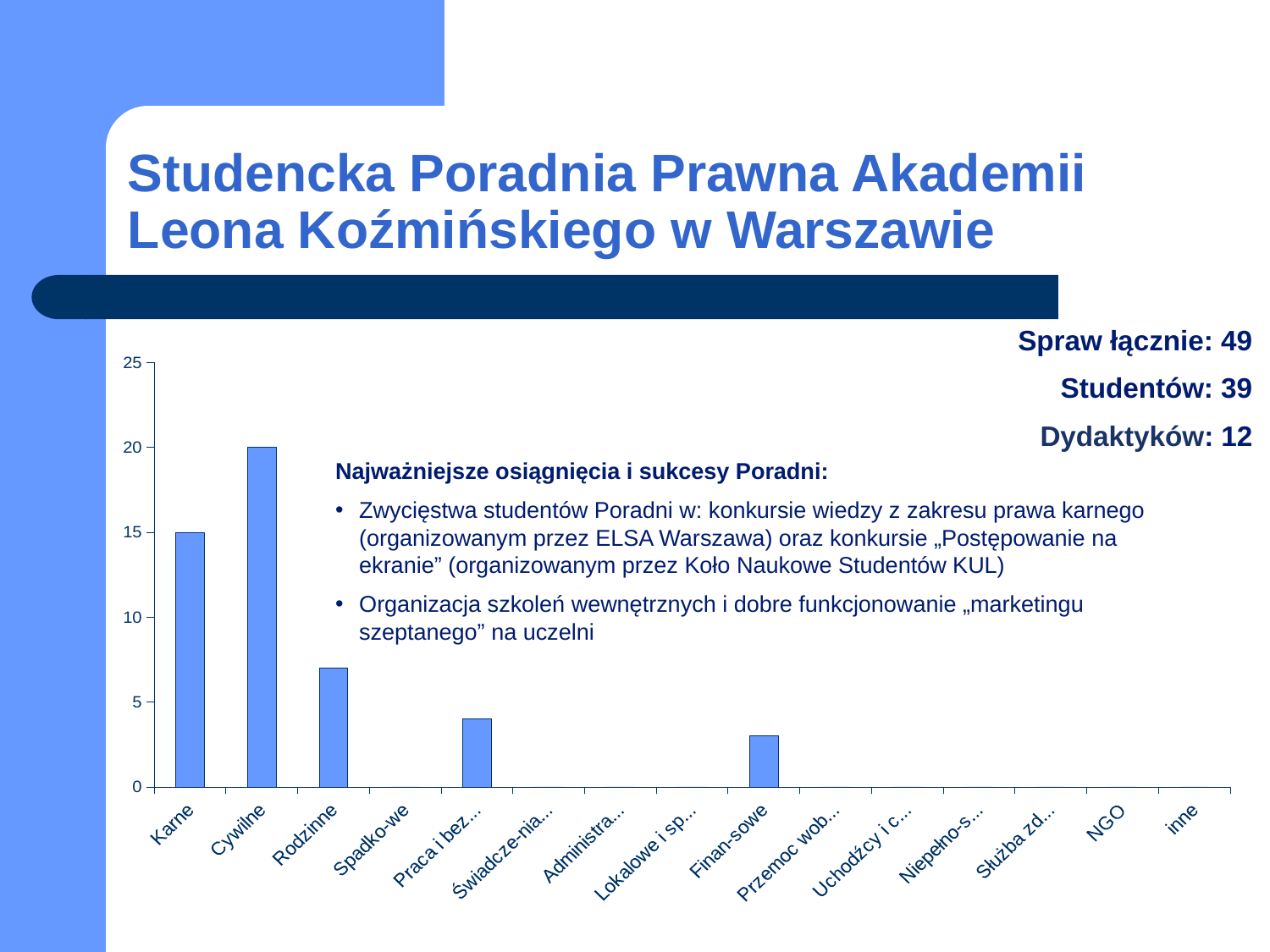
What is the value for Karne in the chart? 15 Is the value for Finan-sowe greater or less than 5? less Which category has the highest bar in the chart? Cywilne What kind of chart is shown on the slide? bar chart What is the difference between the values for Cywilne and Karne? 5 Which is larger, the value for Karne or the value for Rodzinne? Karne What is the value for Cywilne in the chart? 20 Is the value for Rodzinne greater or less than 5? greater Is the value for Praca i bez... greater or less than 5? less How many categories are shown on the x axis of the chart? 15 What is the highest value shown on the y axis of the chart? 25